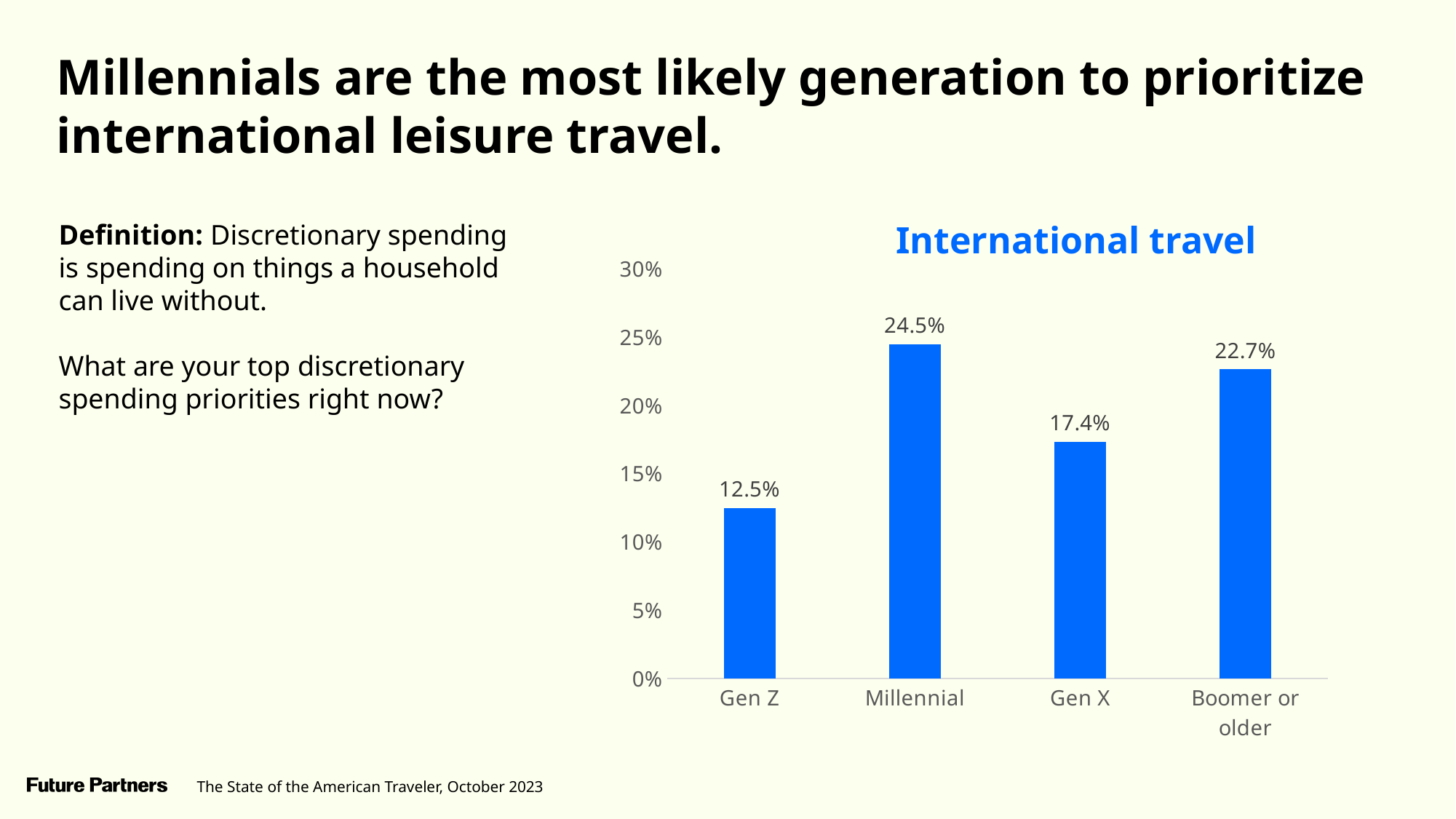
Is the value for Gen X greater or less than 20%? less What is the difference between the values for Boomer or older and Gen X? 5.3% What is the value for Gen Z? 12.5% What is the value for Boomer or older? 22.7% Which generation has the lowest value? Gen Z What is the value for Millennial? 24.5% How many generation categories are shown in the chart? 4 What kind of chart is shown on the slide? bar chart Which is larger, the value for Gen X or the value for Boomer or older? Boomer or older What is the title of the chart? International travel What is the difference between the values for Millennial and Gen Z? 12.0% Which generation has the highest value? Millennial